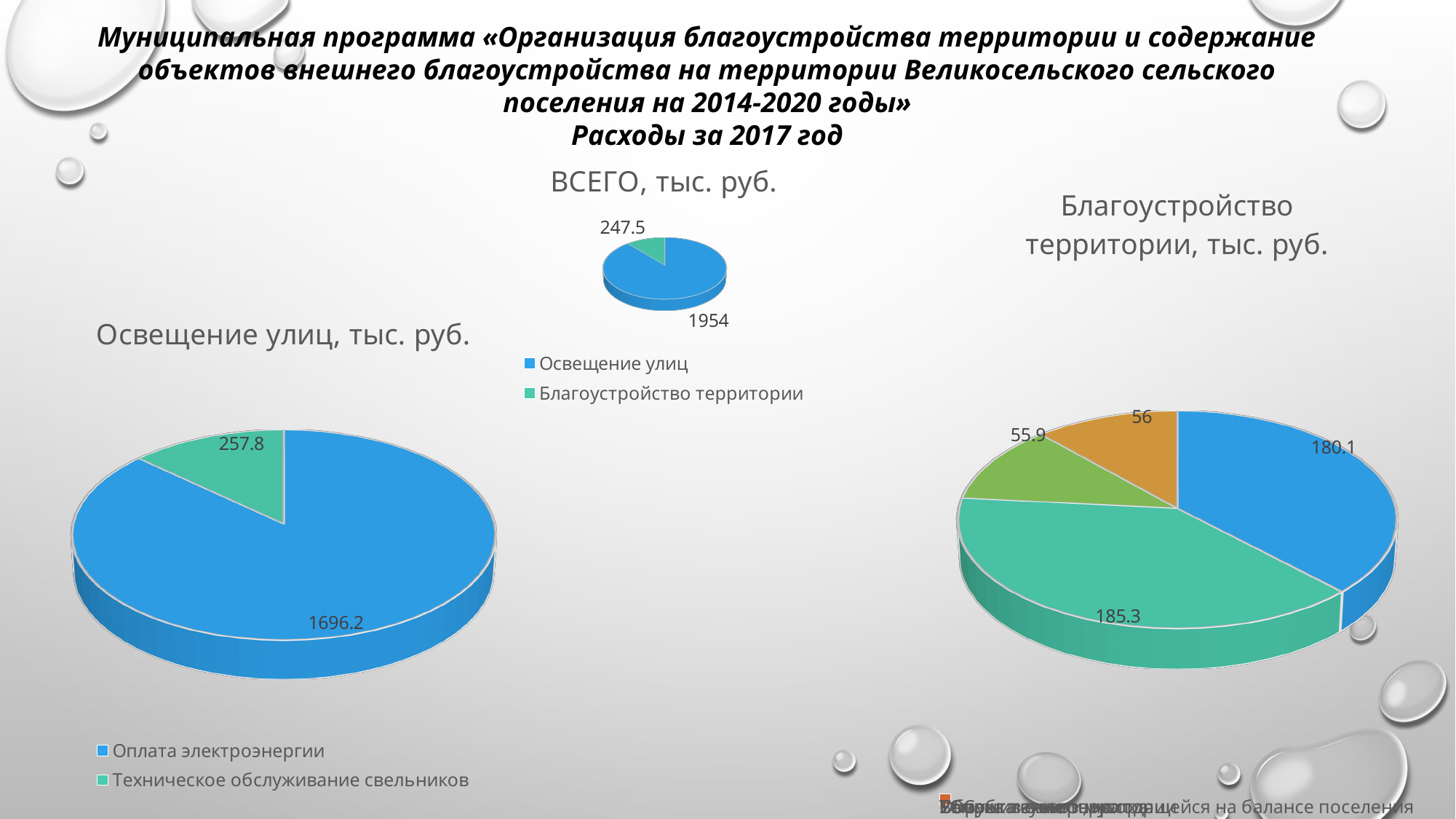
What kind of chart is the chart titled "Освещение улиц, тыс. руб."? pie chart In the chart titled "Освещение улиц, тыс. руб.", which category has the smaller value? Техническое обслуживание свельников In the chart titled "ВСЕГО, тыс. руб.", what is the value for Освещение улиц? 1954 In the chart titled "Благоустройство территории, тыс. руб.", what is the largest value shown? 185.3 How many series does the legend of the chart titled "ВСЕГО, тыс. руб." list? 2 In the chart titled "Освещение улиц, тыс. руб.", what is the value for Оплата электроэнергии? 1696.2 In the chart titled "ВСЕГО, тыс. руб.", what is the value for Благоустройство территории? 247.5 In the chart titled "ВСЕГО, тыс. руб.", what is the difference between the values for Освещение улиц and Благоустройство территории? 1706.5 In the chart titled "Освещение улиц, тыс. руб.", what is the total of the two values shown? 1954 In the chart titled "Освещение улиц, тыс. руб.", what is the value for Техническое обслуживание свельников? 257.8 In the chart titled "ВСЕГО, тыс. руб.", which category has the larger value? Освещение улиц How many slices does the chart titled "Благоустройство территории, тыс. руб." have? 4